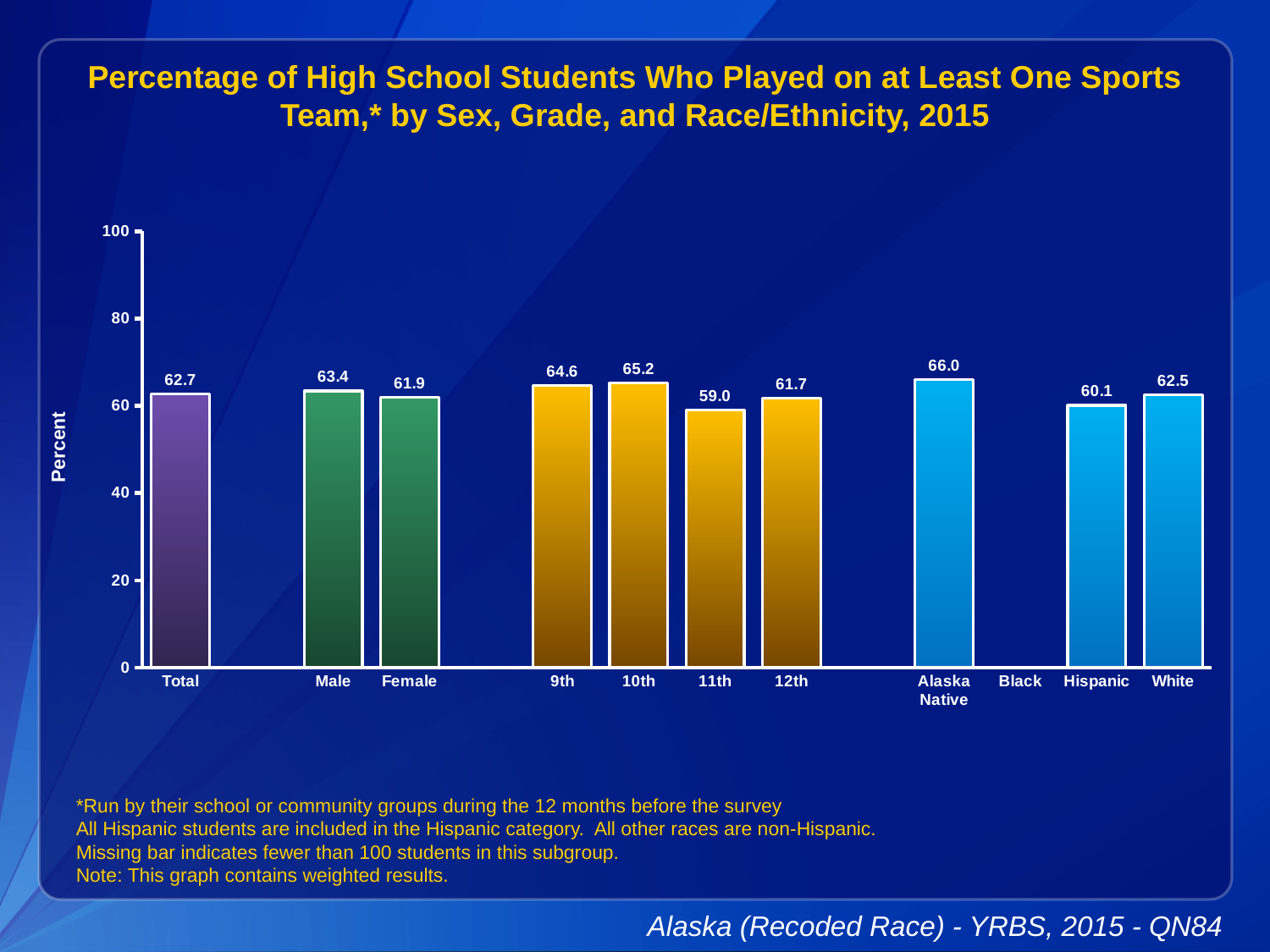
Which category has the lowest value among those with a bar? 11th What kind of chart is shown? bar chart How many categories have a bar plotted? 11 What is the value for Total? 62.7 Which category has no bar shown? Black Is the value for White greater or less than 60? greater What is the value for 11th grade? 59.0 What is the difference between the Male and Female values? 1.5 What is the value for Alaska Native? 66.0 Which is larger, the value for 9th grade or 10th grade? 10th Which category has the highest value? Alaska Native What is the value for Female? 61.9